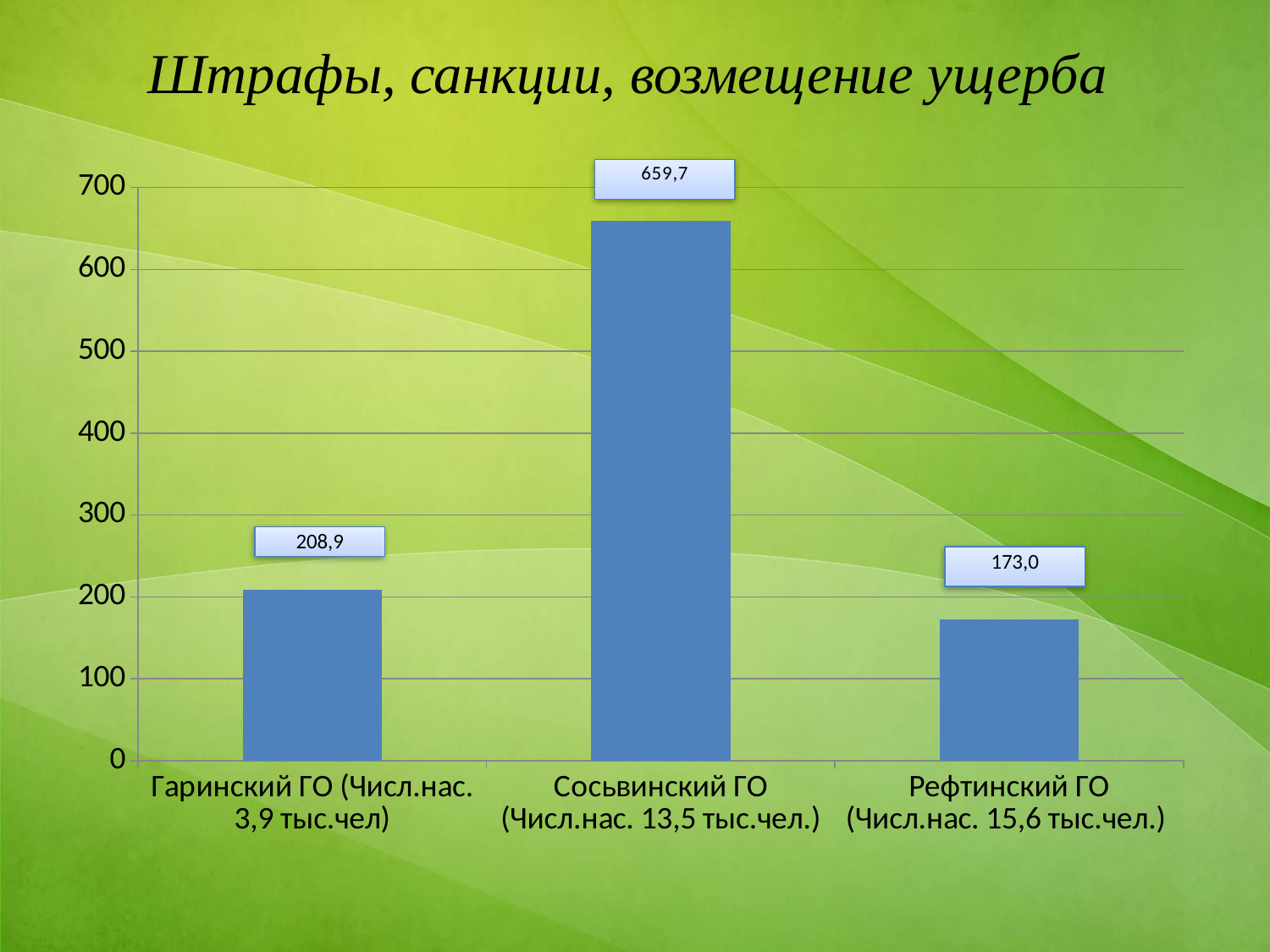
What kind of chart is shown on the slide? bar chart How many categories are shown on the chart? 3 Which is larger, the value for Гаринский ГО or the value for Рефтинский ГО? Гаринский ГО What is the value for Рефтинский ГО? 173,0 What is the difference between the values for Сосьвинский ГО and Гаринский ГО? 450,8 Is the value for Сосьвинский ГО greater or less than 600? greater What is the value for Сосьвинский ГО? 659,7 What is the title of the slide? Штрафы, санкции, возмещение ущерба What is the difference between the values for Гаринский ГО and Рефтинский ГО? 35,9 Which category has the highest value? Сосьвинский ГО Which category has the lowest value? Рефтинский ГО What is the value for Гаринский ГО? 208,9